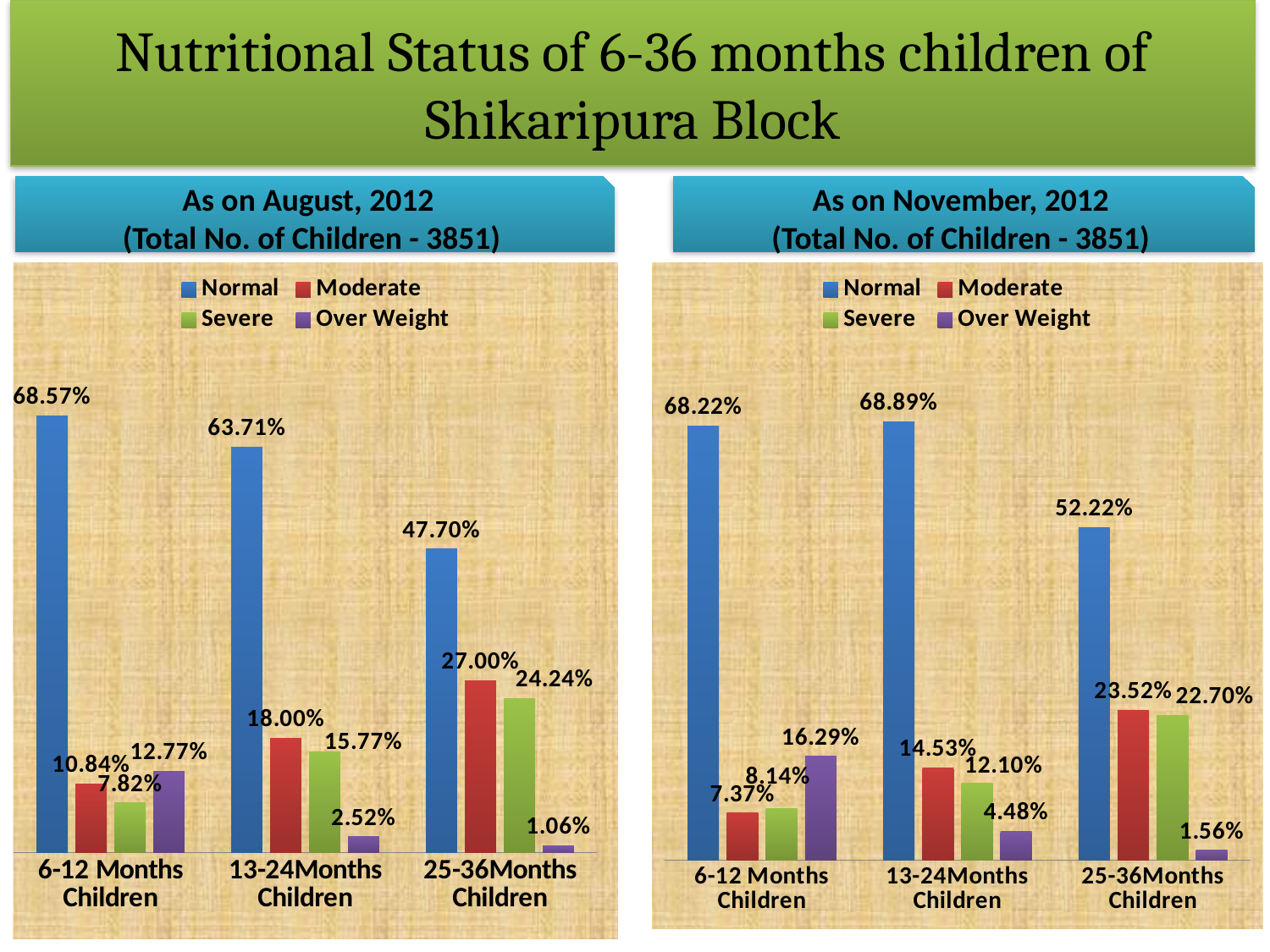
In the 'As on August, 2012' chart, does the Normal value rise or fall from 6-12 Months Children to 25-36Months Children? Fall In the 'As on August, 2012' chart, what is the Moderate value for 25-36 Months Children? 27.00% In the 'As on August, 2012' chart, what is the Normal value for 6-12 Months Children? 68.57% How many series does the legend list in the 'As on August, 2012' chart? 4 In the 'As on November, 2012' chart, which age group has the highest Normal value? 13-24Months Children In the 'As on August, 2012' chart, which age group has the lowest Over Weight value? 25-36Months Children What kind of chart is the 'As on August, 2012' chart? Bar chart In the 'As on November, 2012' chart, which is larger for 25-36Months Children: Moderate or Severe? Moderate In the 'As on August, 2012' chart, what is the difference between the Normal values for 6-12 Months Children and 25-36Months Children? 20.87% How many age-group categories are shown on the x axis of the 'As on November, 2012' chart? 3 In the 'As on November, 2012' chart, what is the Over Weight value for 6-12 Months Children? 16.29% In the 'As on November, 2012' chart, what is the Severe value for 13-24 Months Children? 12.10%